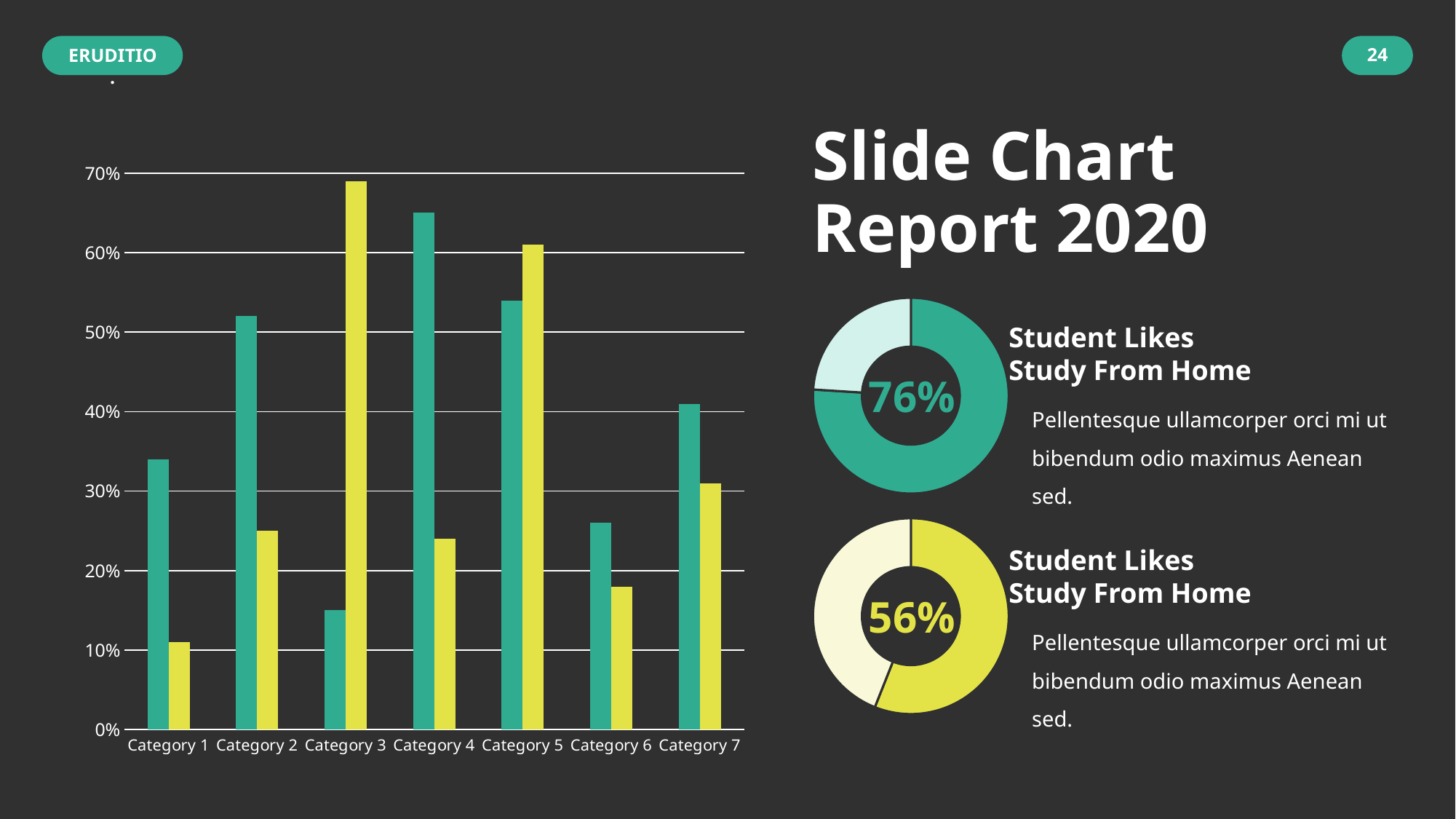
What kind of chart is the large chart on the left of the slide? bar chart In the bar chart on the left, is the yellow bar for Category 3 greater or less than 60%? greater In the bar chart on the left, which category has the tallest yellow bar? Category 3 How many categories are shown on the x axis of the bar chart on the left? 7 In the bar chart on the left, which category has the shortest green bar? Category 3 In the bar chart on the left, which category has the tallest green bar? Category 4 In the bar chart on the left, which category has the shortest yellow bar? Category 1 What percentage is shown in the centre of the lower (yellow) donut chart on the right? 56% In the bar chart on the left, is the green bar for Category 1 greater or less than 30%? greater In the bar chart on the left, is the green bar for Category 3 greater or less than 20%? less What percentage is shown in the centre of the upper (green) donut chart on the right? 76% In the bar chart on the left, for Category 2, which bar is taller, the green one or the yellow one? the green one